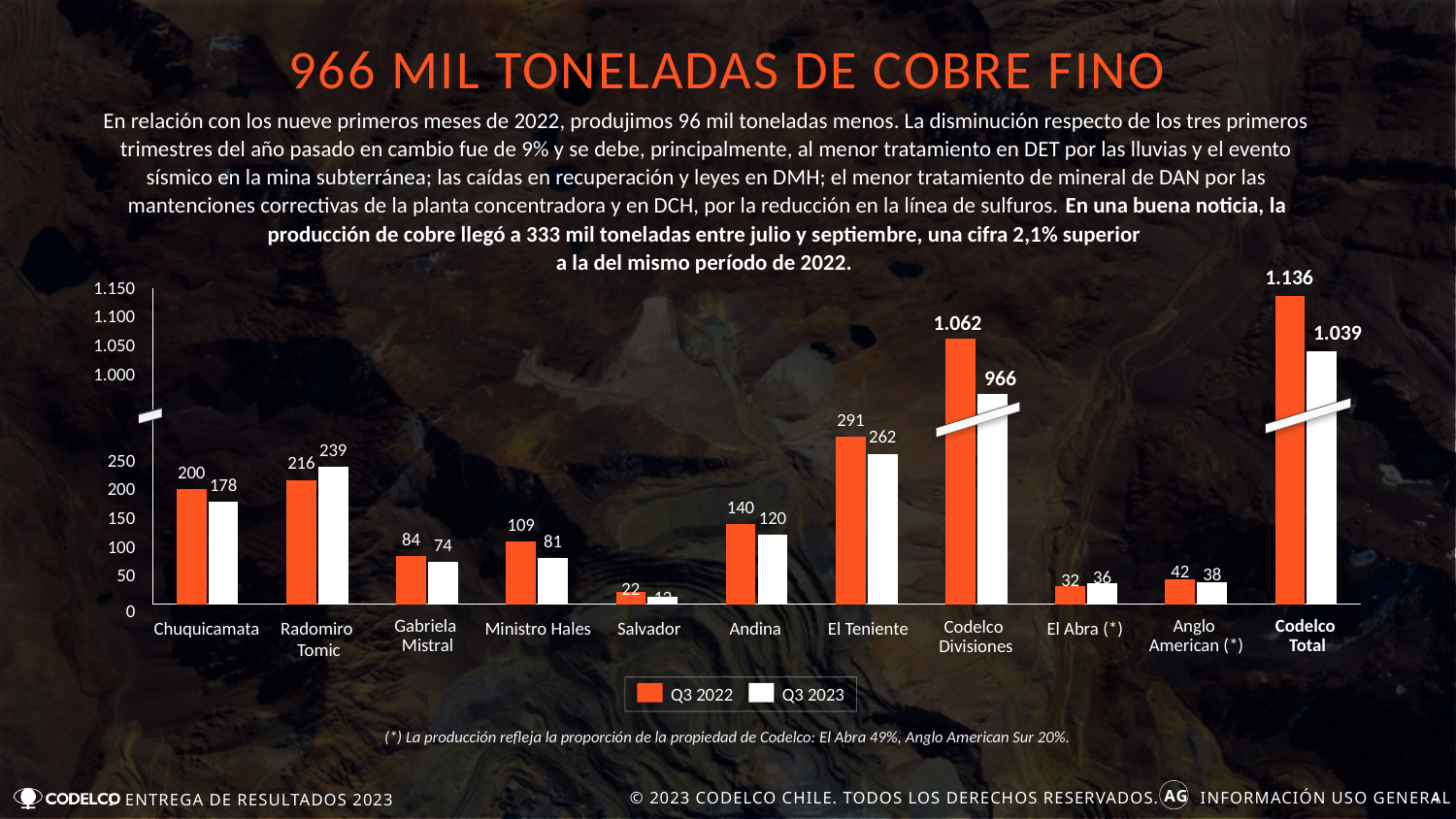
What is the Q3 2022 value for Chuquicamata? 200 Among the individual divisions (excluding Codelco Divisiones and Codelco Total), which has the highest Q3 2022 value? El Teniente What is the Q3 2023 value for Codelco Divisiones? 966 What is the Q3 2022 value for Codelco Total? 1.136 Which is larger for El Abra (*): the Q3 2022 value or the Q3 2023 value? Q3 2023 What is the difference between the Q3 2022 and Q3 2023 values for El Teniente? 29 Which category has the highest Q3 2023 value? Codelco Total What is the Q3 2023 value for Radomiro Tomic? 239 What kind of chart is shown on the slide? Bar chart How many categories are shown on the x axis? 11 How many series does the legend list? 2 Which colour represents the Q3 2022 series in the legend? Orange